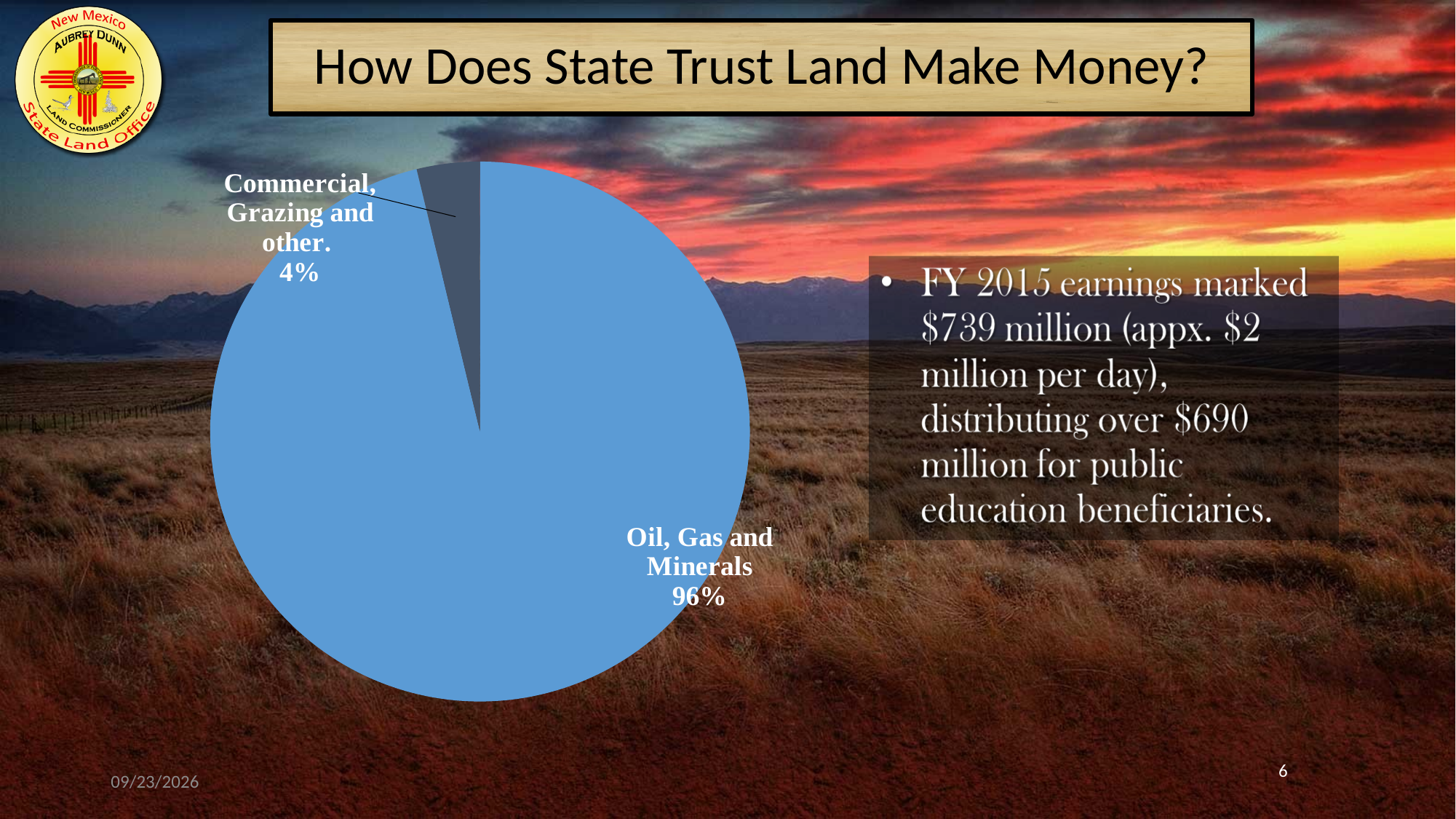
What is the difference in percentage points between the Oil, Gas and Minerals slice and the Commercial, Grazing and other slice? 92 How many slices does the pie chart have? 2 What is the title shown above the pie chart on the slide? How Does State Trust Land Make Money? What kind of chart is shown on the slide? pie chart What share of the pie does Commercial, Grazing and other represent? 4% Which is larger: the Oil, Gas and Minerals slice or the Commercial, Grazing and other slice? Oil, Gas and Minerals What colour is the Oil, Gas and Minerals slice of the pie chart? blue What share of the pie does Oil, Gas and Minerals represent? 96% Which slice of the pie chart is the largest? Oil, Gas and Minerals Which slice of the pie chart is the smallest? Commercial, Grazing and other